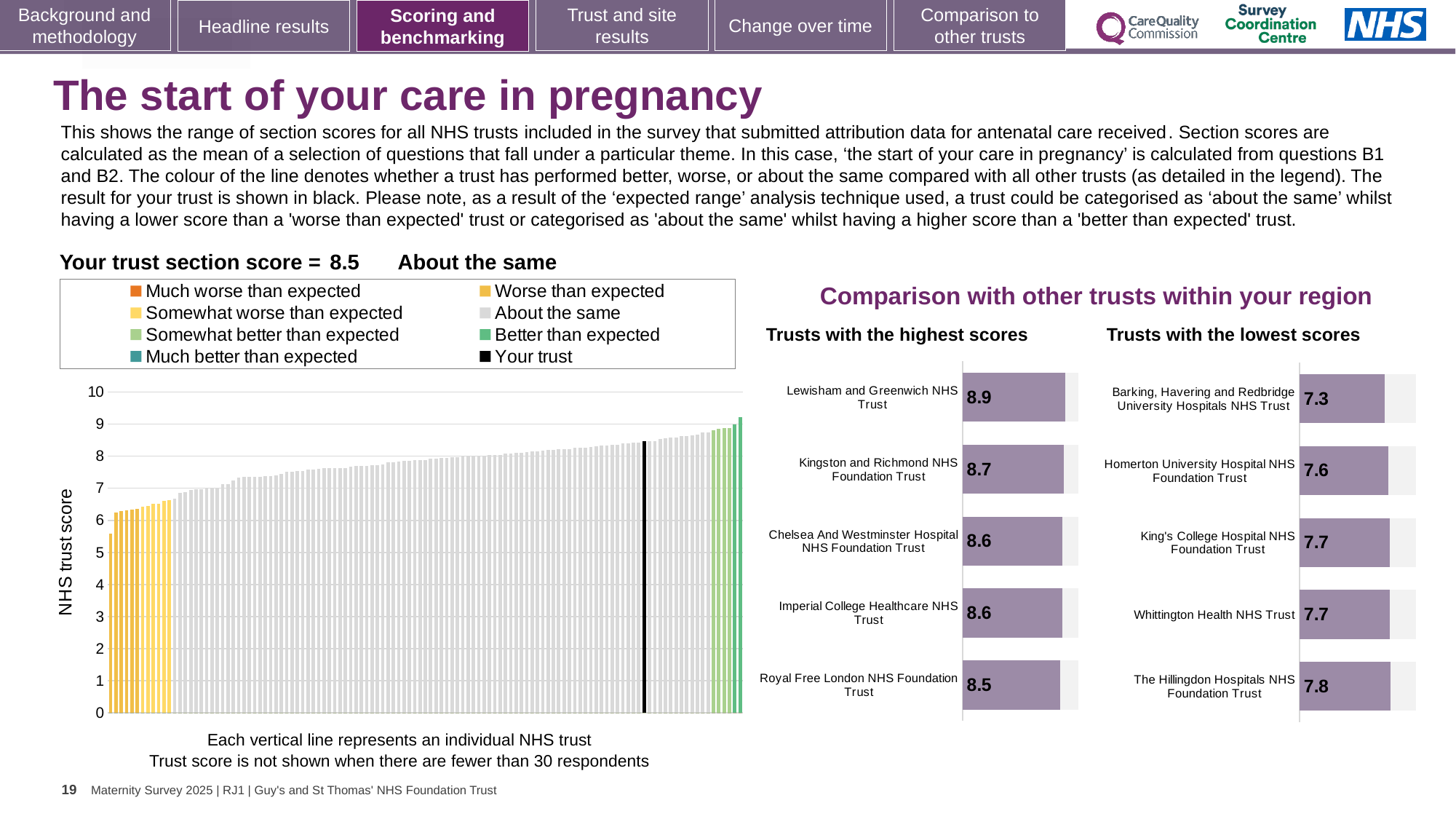
In the 'Trusts with the highest scores' chart, what is the score for Lewisham and Greenwich NHS Trust? 8.9 In the 'Trusts with the lowest scores' chart, what is the difference between the scores of The Hillingdon Hospitals NHS Foundation Trust and Barking, Havering and Redbridge University Hospitals NHS Trust? 0.5 How many trusts are shown in the 'Trusts with the highest scores' chart? 5 What kind of chart is the large chart on the left showing NHS trust scores? Bar chart In the 'Trusts with the lowest scores' chart, what is the score for Homerton University Hospital NHS Foundation Trust? 7.6 In the 'Trusts with the highest scores' chart, what is the score for Royal Free London NHS Foundation Trust? 8.5 In the 'Trusts with the lowest scores' chart, which trust has the lowest score? Barking, Havering and Redbridge University Hospitals NHS Trust In the 'Trusts with the highest scores' chart, which trust has the highest score? Lewisham and Greenwich NHS Trust In the 'Trusts with the lowest scores' chart, which has the higher score: Homerton University Hospital NHS Foundation Trust or The Hillingdon Hospitals NHS Foundation Trust? The Hillingdon Hospitals NHS Foundation Trust In the 'Trusts with the highest scores' chart, what is the difference between the scores of Lewisham and Greenwich NHS Trust and Royal Free London NHS Foundation Trust? 0.4 In the large chart on the left, is the value of the black bar (your trust) greater or less than 8? greater In the large chart on the left, do the trust scores rise or fall from left to right? Rise